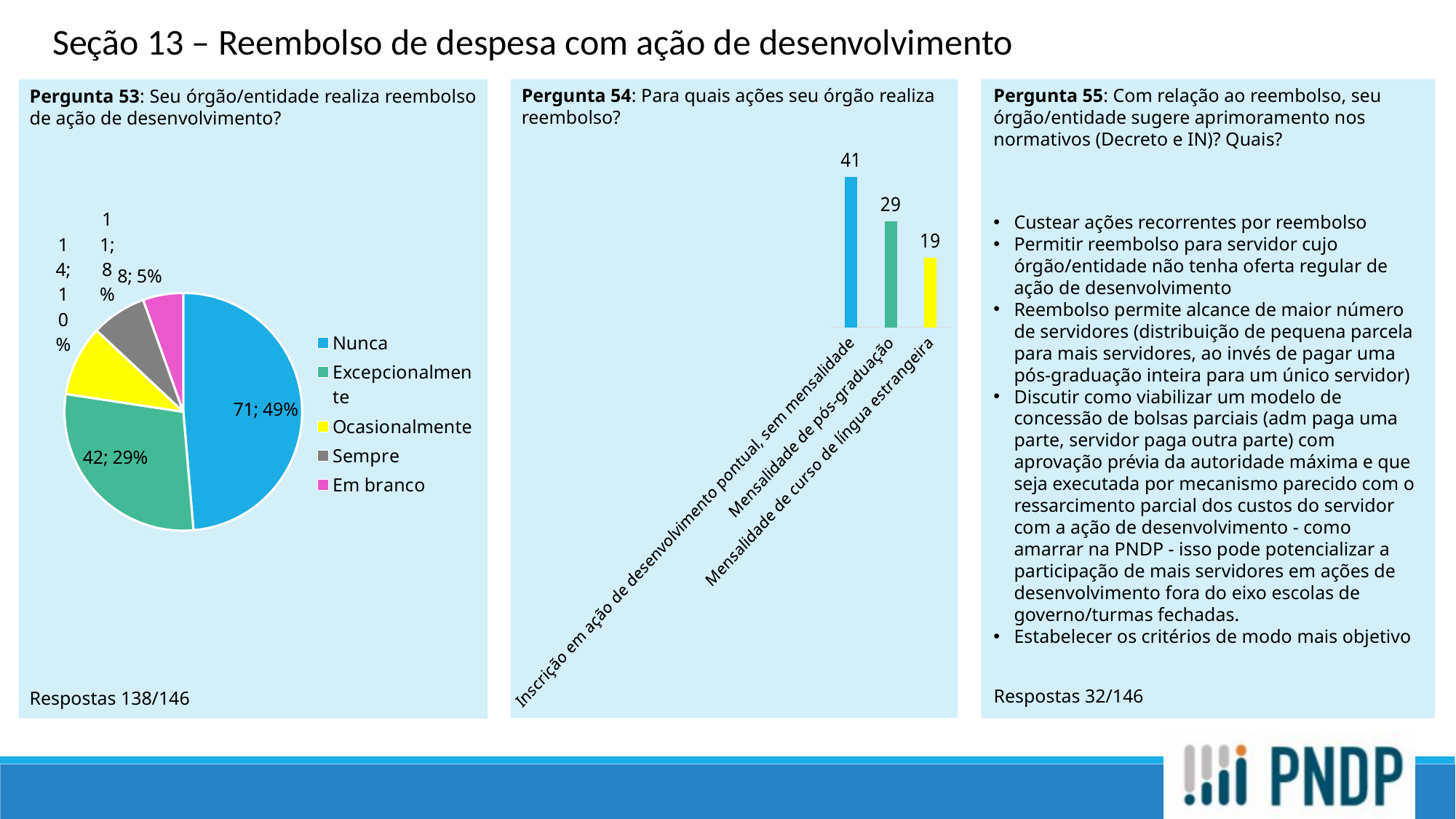
In the Pergunta 53 pie chart, which is larger: 'Excepcionalmente' or 'Em branco'? Excepcionalmente In the Pergunta 54 bar chart, how many categories are shown? 3 In the Pergunta 54 bar chart, which category has the highest value? Inscrição em ação de desenvolvimento pontual, sem mensalidade In the Pergunta 53 pie chart, which category has the largest slice? Nunca In the Pergunta 53 pie chart, what value and percentage are shown for 'Nunca'? 71; 49% In the Pergunta 54 bar chart, do the values rise or fall from left to right? Fall In the Pergunta 54 bar chart, which category has the lowest value? Mensalidade de curso de língua estrangeira In the Pergunta 54 bar chart, what is the difference between the values for 'Inscrição em ação de desenvolvimento pontual, sem mensalidade' and 'Mensalidade de curso de língua estrangeira'? 22 In the Pergunta 54 bar chart, what is the value for 'Mensalidade de pós-graduação'? 29 What kind of chart is used for Pergunta 54? Bar chart How many entries does the legend of the Pergunta 53 pie chart list? 5 In the Pergunta 53 pie chart, what share of the pie does 'Excepcionalmente' have? 29%